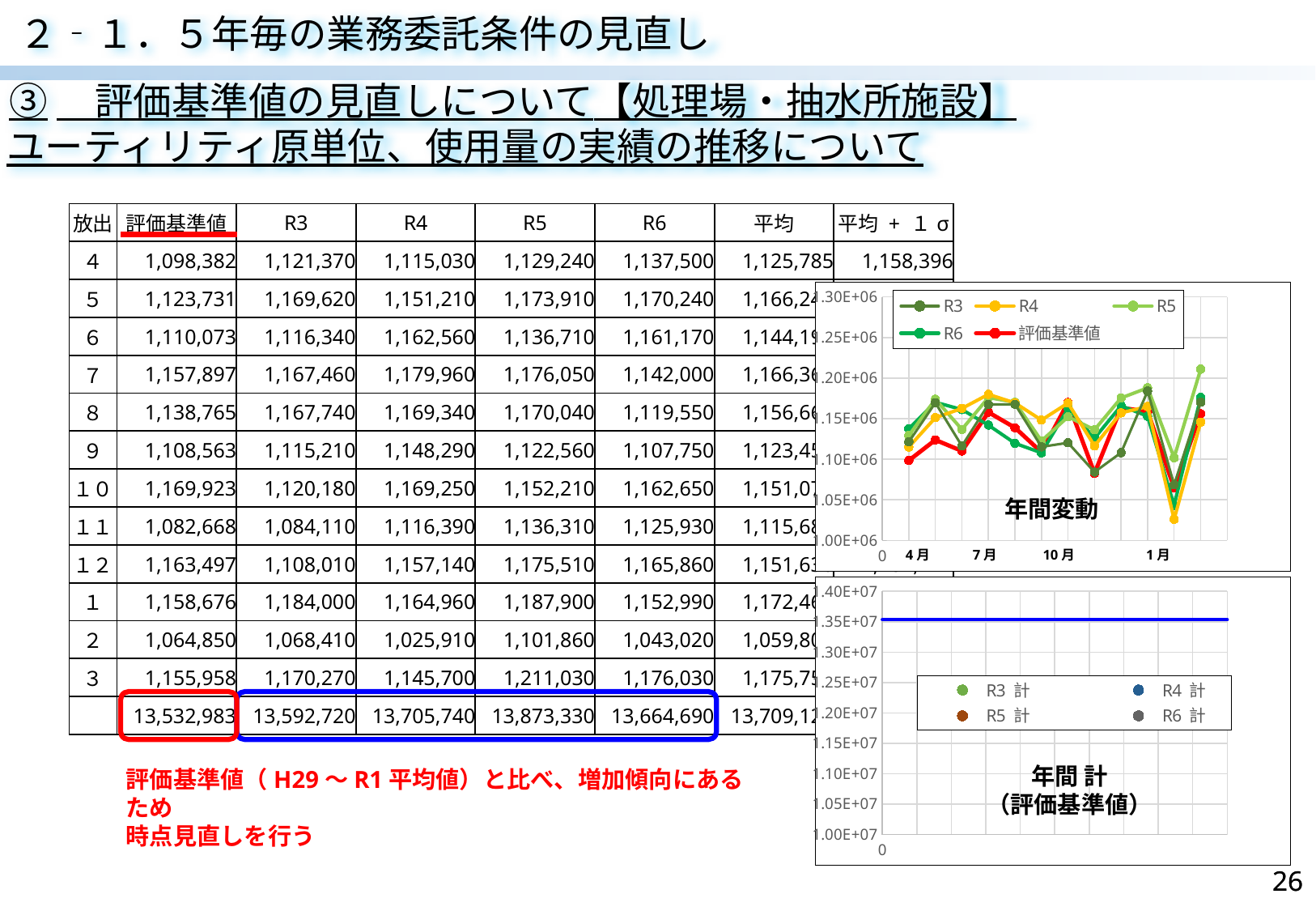
In the chart titled 年間 計（評価基準値）, is the blue horizontal line greater or less than 1.30E+07? greater In the chart titled 年間変動, what are the series names listed in the legend? R3, R4, R5, R6, 評価基準値 In the chart titled 年間変動, which series drops to the lowest point on the chart? R4 In the chart titled 年間変動, which series is drawn in red? 評価基準値 In the chart titled 年間変動, is the highest point of the R5 series greater or less than 1.20E+06? greater In the chart titled 年間 計（評価基準値）, is the blue horizontal line greater or less than 1.40E+07? less In the chart titled 年間変動, how many series does the legend list? 5 In the chart titled 年間変動, what is the highest value shown on the vertical axis? 1.30E+06 What kind of chart is the one titled 年間変動? line chart In the chart titled 年間 計（評価基準値）, how many entries does the legend list? 4 In the chart titled 年間変動, which series reaches the highest point on the chart? R5